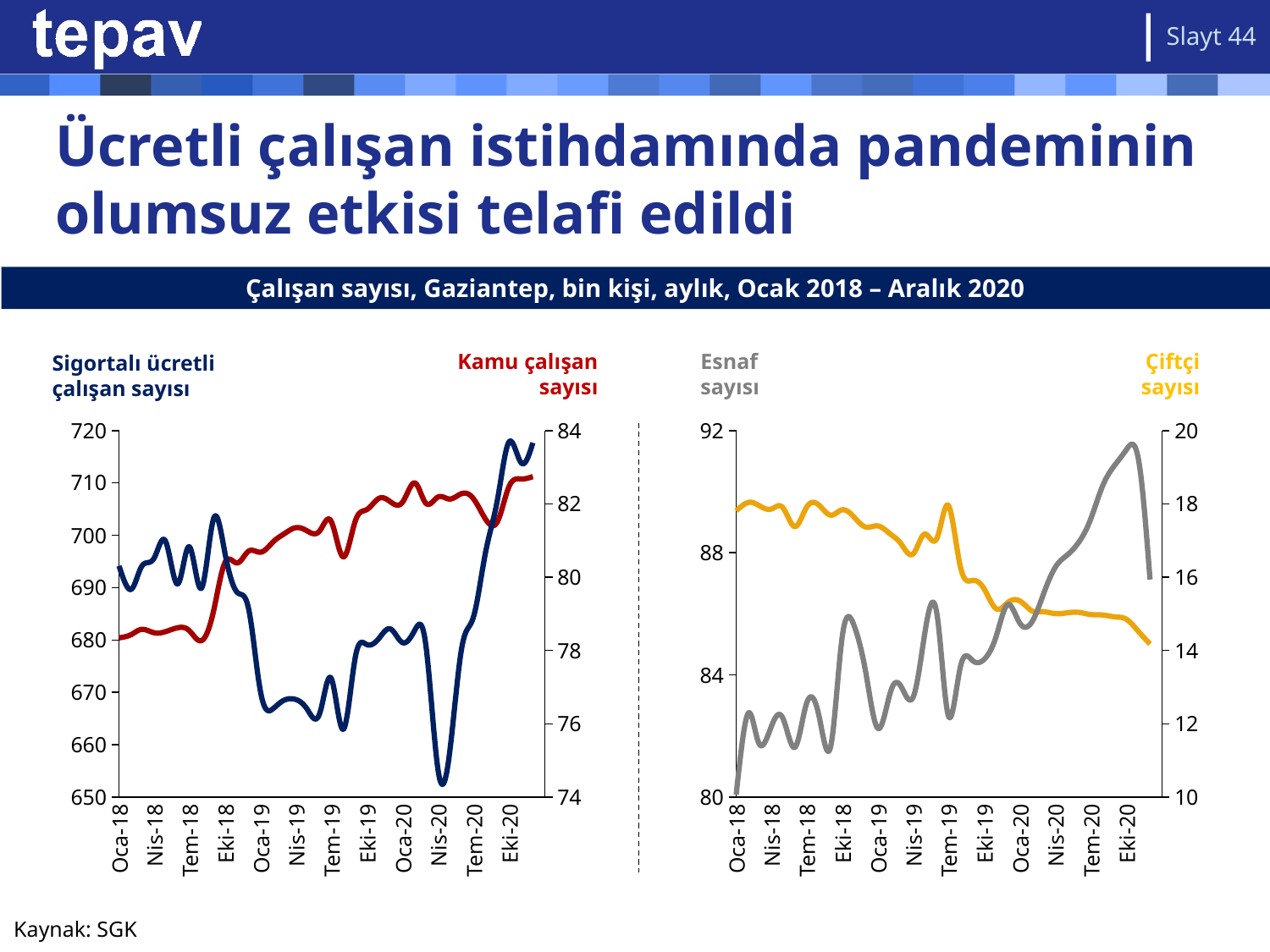
In the right chart, is the value of Çiftçi sayısı at Eki-20 greater or less than 16? less In the left chart, how many series are plotted? 2 In the left chart, is the value of Sigortalı ücretli çalışan sayısı at Nis-20 greater or less than 660? less What type of chart is used on the left side of the slide? Line chart In the right chart, does Esnaf sayısı generally rise or fall from Oca-18 to Eki-20? rise In the right chart, which series is drawn in yellow? Çiftçi sayısı In the right chart, does Çiftçi sayısı generally rise or fall from Oca-18 to Eki-20? fall What is the title shown in the banner above the charts? Çalışan sayısı, Gaziantep, bin kişi, aylık, Ocak 2018 – Aralık 2020 In the left chart, is the value of Kamu çalışan sayısı at Eki-20 greater or less than 82? greater How many charts are shown on the slide? 2